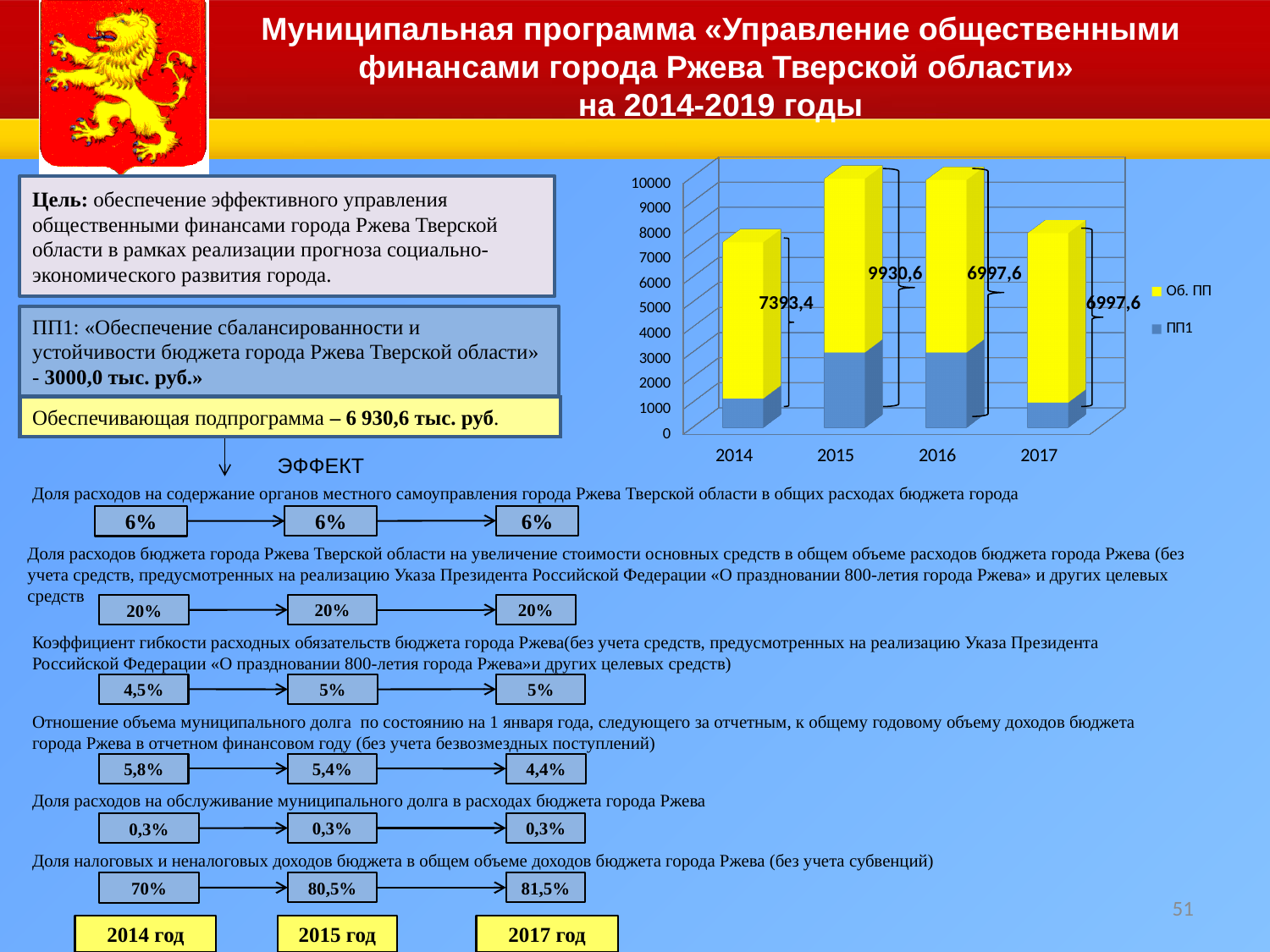
Is the total height of the bar for 2014 greater or less than 5000? greater Which bar is taller overall, 2014 or 2015? 2015 What data label is printed on the bar for 2014? 7393,4 Is the ПП1 segment for 2017 greater or less than 2000? less What kind of chart is shown on the slide? bar chart Which ПП1 segment is larger, 2015 or 2017? 2015 Which series is shown in yellow in the chart? Об. ПП What data label is printed on the bar for 2015? 9930,6 What data label is printed on the bar for 2017? 6997,6 Is the total height of the bar for 2015 greater or less than 9000? greater How many years are shown on the x axis of the chart? 4 How many series does the chart legend list? 2